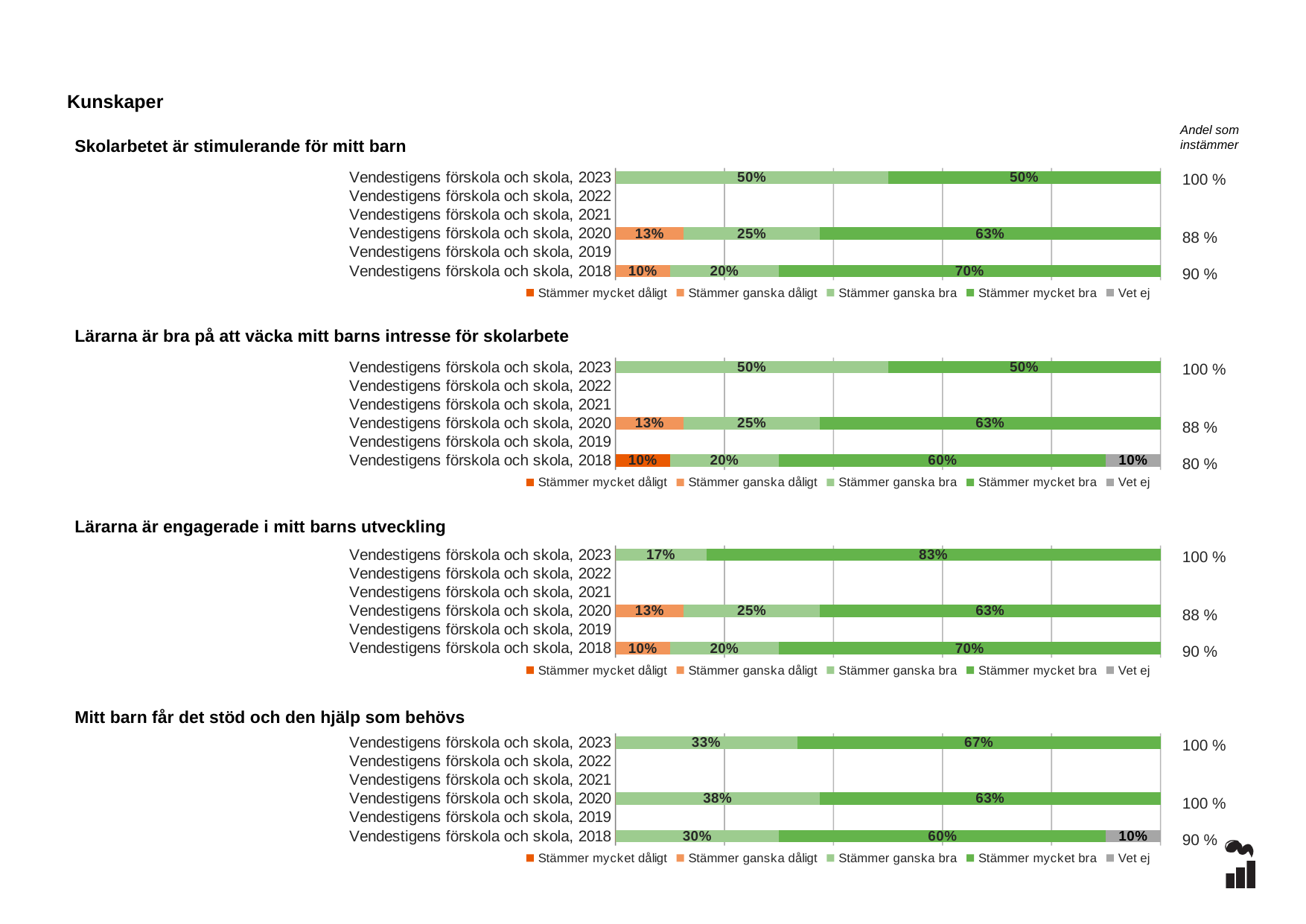
How many series does the legend list in the chart 'Skolarbetet är stimulerande för mitt barn'? 5 In the chart 'Mitt barn får det stöd och den hjälp som behövs', what is the 'Stämmer ganska bra' value for Vendestigens förskola och skola, 2020? 38% In the chart 'Lärarna är engagerade i mitt barns utveckling', what is the 'Stämmer mycket bra' value for Vendestigens förskola och skola, 2023? 83% In the chart 'Lärarna är engagerade i mitt barns utveckling', which year has the highest 'Stämmer mycket bra' value? 2023 In the chart 'Skolarbetet är stimulerande för mitt barn', what is the 'Stämmer ganska dåligt' value for Vendestigens förskola och skola, 2020? 13% In the chart 'Mitt barn får det stöd och den hjälp som behövs', what is the total of the 2018 bar including 'Vet ej'? 100% In the chart 'Mitt barn får det stöd och den hjälp som behövs', is the 'Stämmer mycket bra' value larger for 2023 or for 2018? 2023 In the chart 'Mitt barn får det stöd och den hjälp som behövs', what is the 'Andel som instämmer' for Vendestigens förskola och skola, 2018? 90 % What kind of chart is 'Lärarna är engagerade i mitt barns utveckling'? Stacked bar chart In the chart 'Lärarna är bra på att väcka mitt barns intresse för skolarbete', what is the difference between the 'Stämmer mycket bra' values for 2020 and 2018? 3% In the chart 'Skolarbetet är stimulerande för mitt barn', what is the 'Stämmer mycket bra' value for Vendestigens förskola och skola, 2018? 70% In the chart 'Lärarna är bra på att väcka mitt barns intresse för skolarbete', what is the 'Vet ej' value for Vendestigens förskola och skola, 2018? 10%